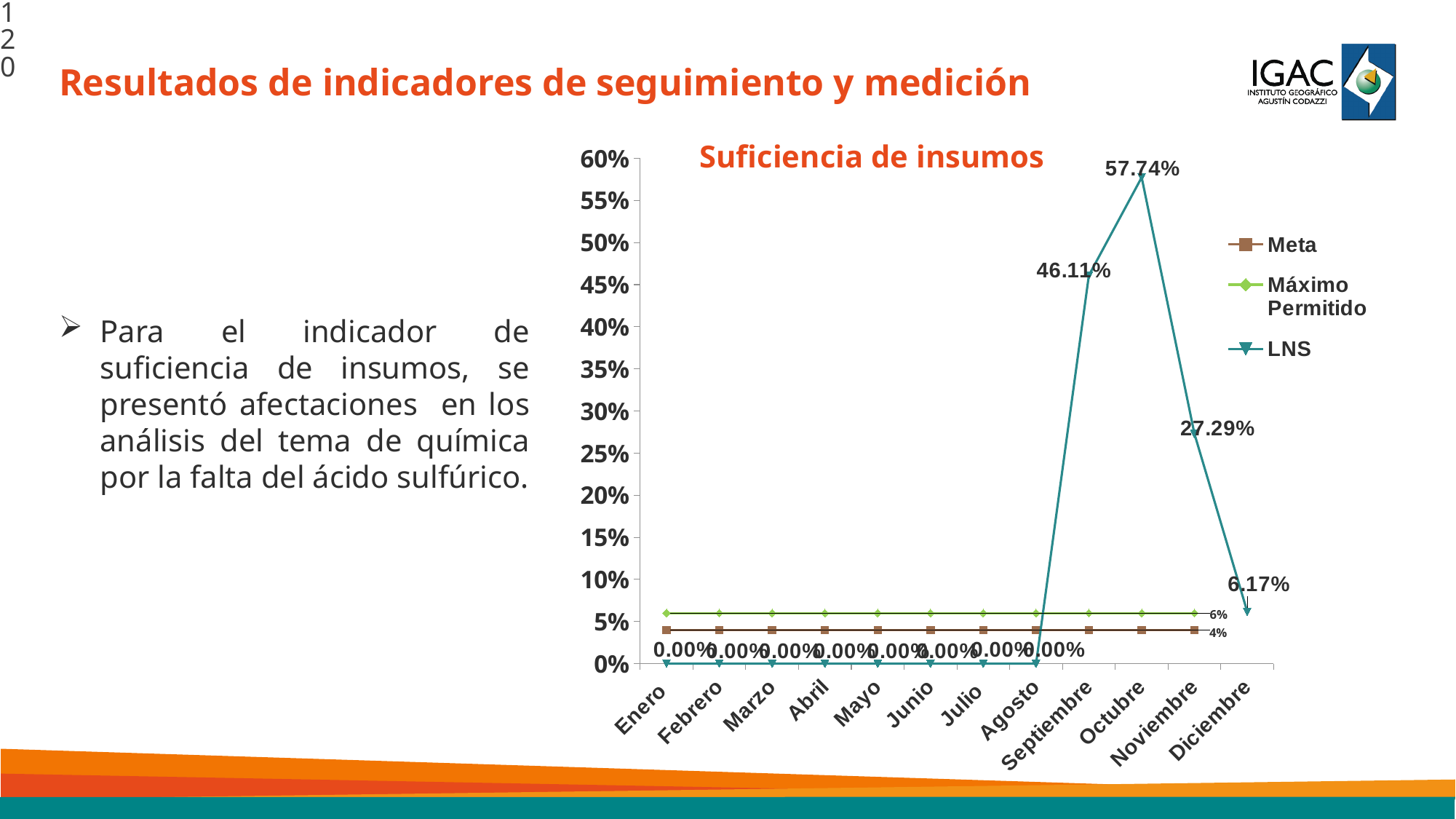
What is the title of the chart? Suficiencia de insumos How many series does the chart legend list? 3 In which month does the LNS series reach its highest value? Octubre What is the LNS value for Octubre? 57.74% What is the value of the Máximo Permitido series? 6% What is the LNS value for Diciembre? 6.17% What type of chart is shown on the slide? line chart What is the difference between the LNS values for Octubre and Noviembre? 30.45% What is the LNS value for Septiembre? 46.11% Does the LNS series rise or fall from Octubre to Diciembre? fall Which is larger, the LNS value for Septiembre or for Noviembre? Septiembre How many months are shown on the x axis of the chart? 12